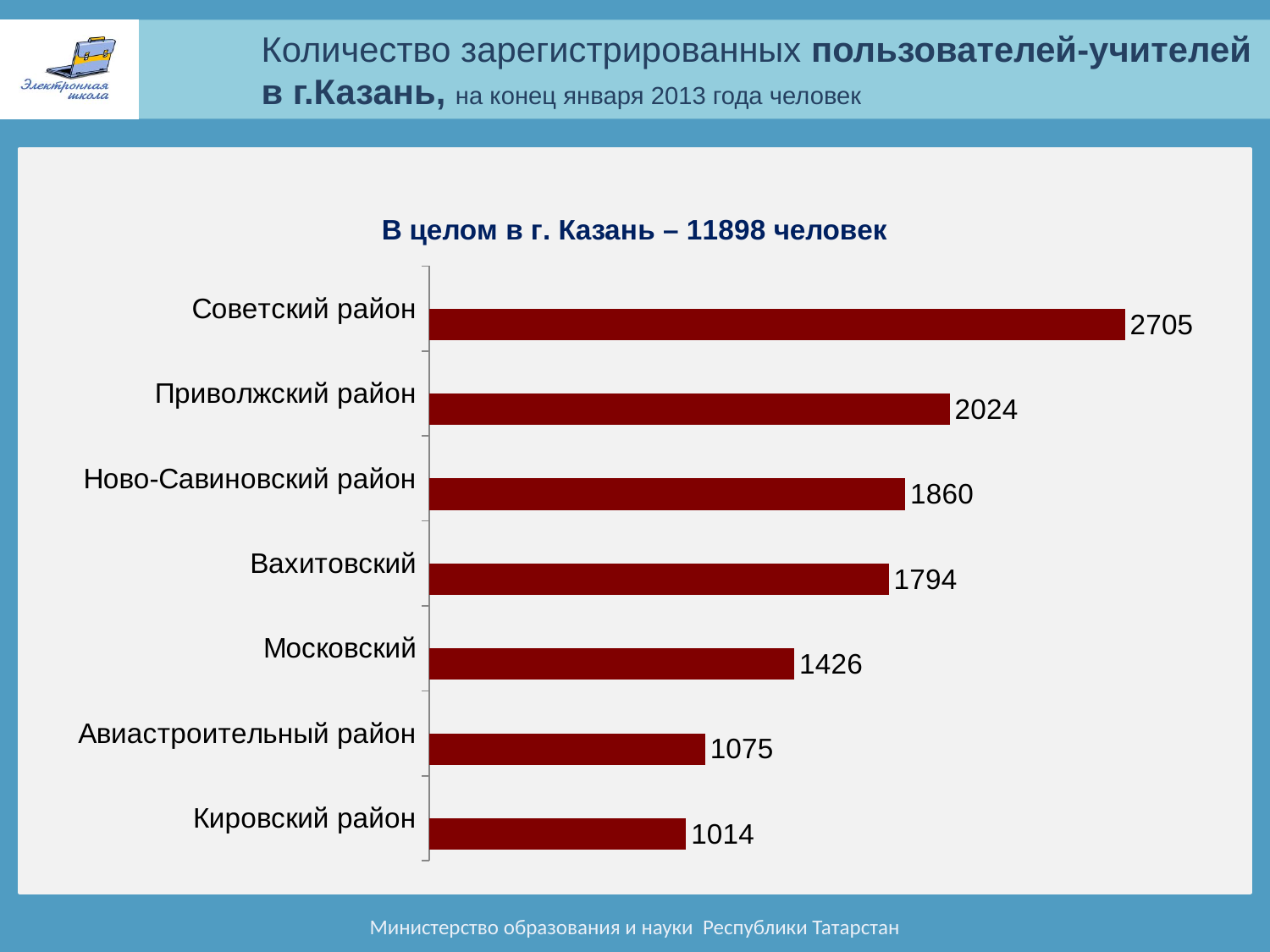
Which district has the lowest number of registered teacher-users? Кировский район Which is larger, the value for Ново-Савиновский район or the value for Вахитовский? Ново-Савиновский район What is the value for Московский? 1426 What kind of chart is shown on the slide? bar chart What is the difference between the values for Советский район and Приволжский район? 681 What colour are the bars in the chart? dark red How many districts are shown in the chart? 7 What is the value for Советский район? 2705 What is the difference between the values for Авиастроительный район and Кировский район? 61 What total number of people for Kazan as a whole is stated above the chart? 11898 What is the value for Кировский район? 1014 Which district has the highest number of registered teacher-users? Советский район